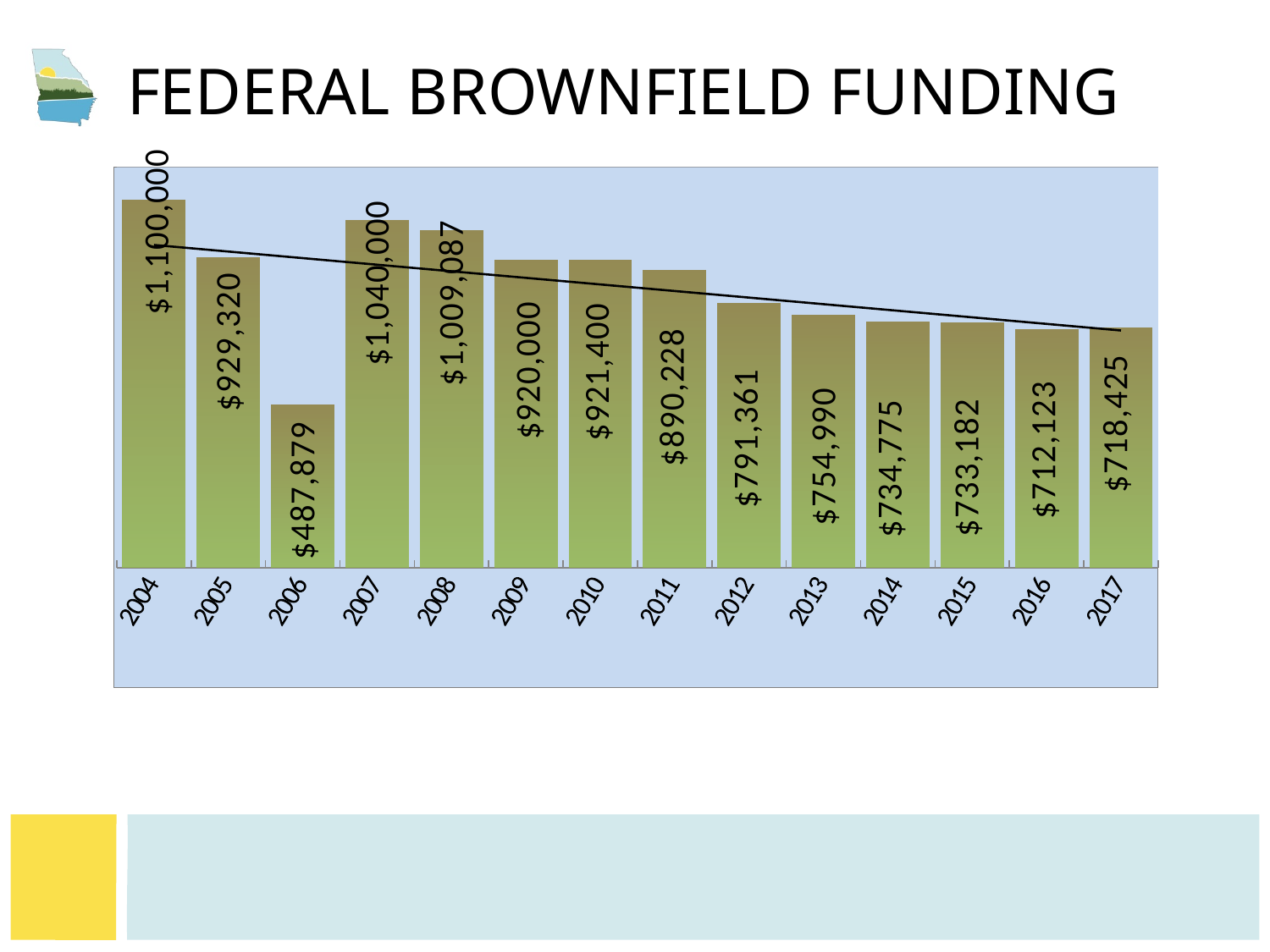
What is the overall trend of federal brownfield funding from 2007 to 2016? Falling What was the federal brownfield funding in 2017? $718,425 Which year had the lowest federal brownfield funding? 2006 Which year had the highest federal brownfield funding? 2004 How many years are shown on the chart? 14 What is the difference between the funding in 2007 and the funding in 2006? $552,121 What was the federal brownfield funding in 2006? $487,879 What was the federal brownfield funding in 2011? $890,228 What is the difference between the funding in 2004 and the funding in 2017? $381,575 Which year had higher funding, 2009 or 2010? 2010 What was the federal brownfield funding in 2004? $1,100,000 What kind of chart is shown on the slide? Bar chart